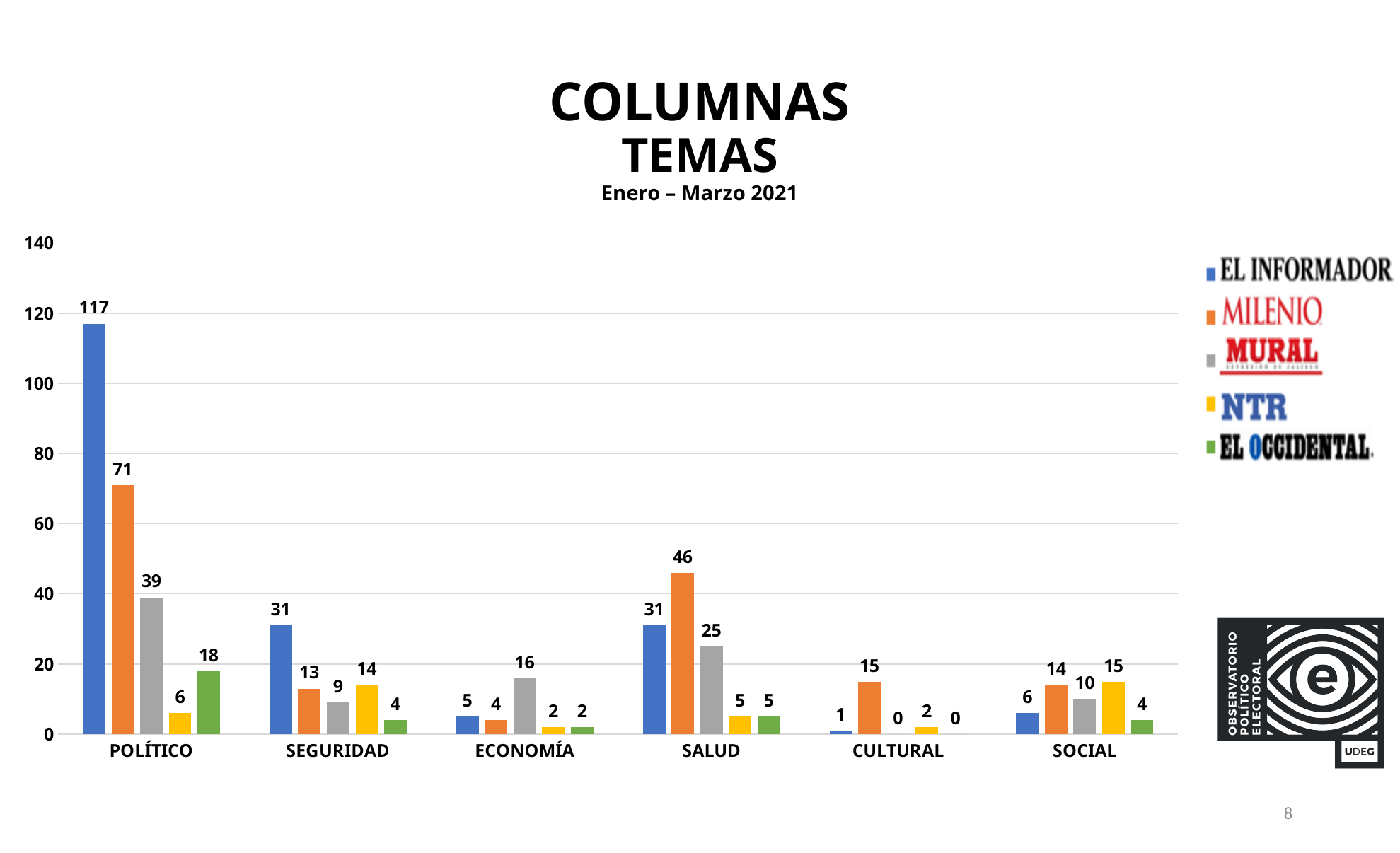
How many newspapers (series) does the legend list? 5 What is the value for Milenio in the SALUD category? 46 Which is larger in the SALUD category: El Informador or Milenio? Milenio What is the value for Mural in the ECONOMÍA category? 16 How many topic categories are shown on the x axis? 6 What is the value for NTR in the SOCIAL category? 15 What is the value for El Informador in the POLÍTICO category? 117 Is the value for Milenio in the POLÍTICO category greater or less than 60? greater Which newspaper has the lowest value in the SEGURIDAD category? El Occidental Which newspaper has the highest value in the CULTURAL category? Milenio What is the difference between El Informador and Milenio in the POLÍTICO category? 46 What kind of chart is shown on the slide? Bar chart